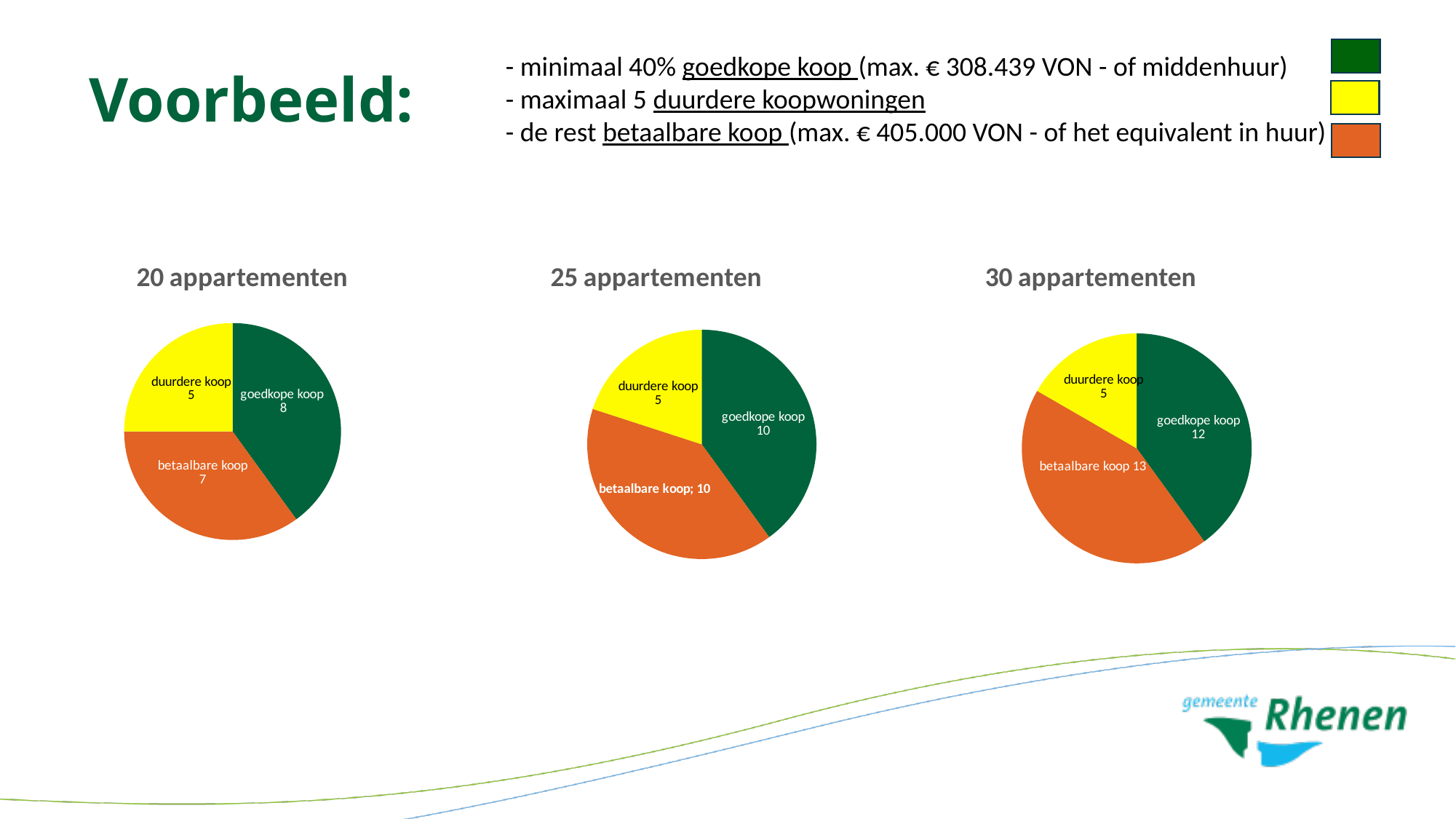
What colour represents 'duurdere koop' in the pie charts? yellow In the '20 appartementen' pie chart, what is the difference between 'goedkope koop' and 'duurdere koop'? 3 In the '20 appartementen' pie chart, which category has the largest slice? goedkope koop In the '25 appartementen' pie chart, what is the value for 'betaalbare koop'? 10 In the '30 appartementen' pie chart, which is larger: 'goedkope koop' or 'duurdere koop'? goedkope koop In the '20 appartementen' pie chart, what share of the total is 'goedkope koop'? 40% In the '30 appartementen' pie chart, which category has the smallest slice? duurdere koop In the '30 appartementen' pie chart, what is the value for 'betaalbare koop'? 13 In the '20 appartementen' pie chart, how many apartments are 'goedkope koop'? 8 How many slices does the '25 appartementen' pie chart have? 3 What type of chart is used for '30 appartementen'? pie chart In the '30 appartementen' pie chart, which category has the largest slice? betaalbare koop